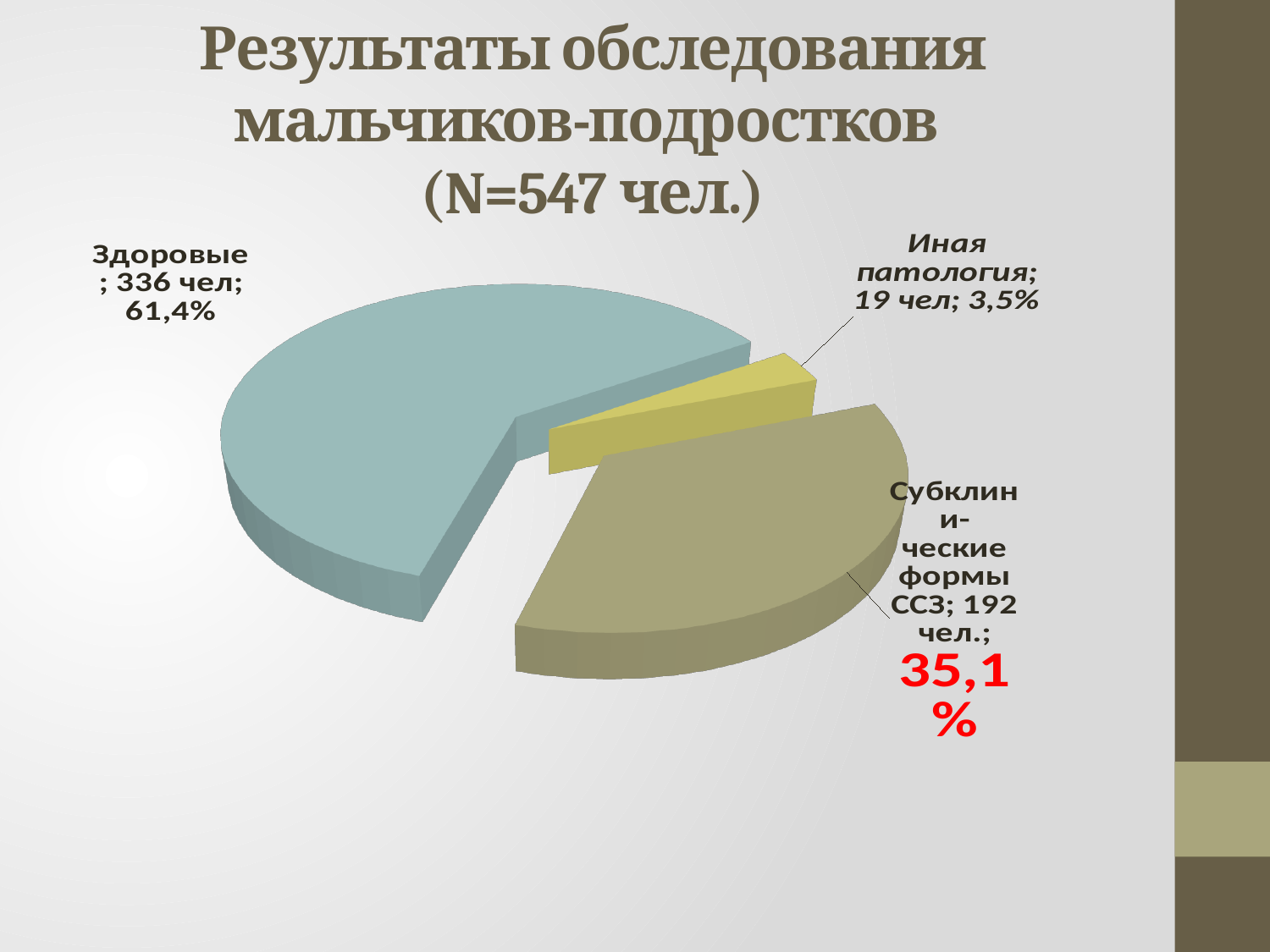
How many slices does the pie chart have? 3 What percentage share does the "Иная патология" slice have? 3,5% How many people are in the "Иная патология" category? 19 чел Which category has the smallest slice of the pie? Иная патология What percentage share does the "Субклинические формы ССЗ" slice have? 35,1% What is the total number of people (N) stated in the chart title? 547 чел. What percentage share does the "Здоровые" slice have? 61,4% Which category has the largest slice of the pie? Здоровые What kind of chart is shown on the slide? Pie chart How many people are in the "Здоровые" category? 336 чел What is the difference in number of people between "Здоровые" and "Субклинические формы ССЗ"? 144 чел How many people are in the "Субклинические формы ССЗ" category? 192 чел.